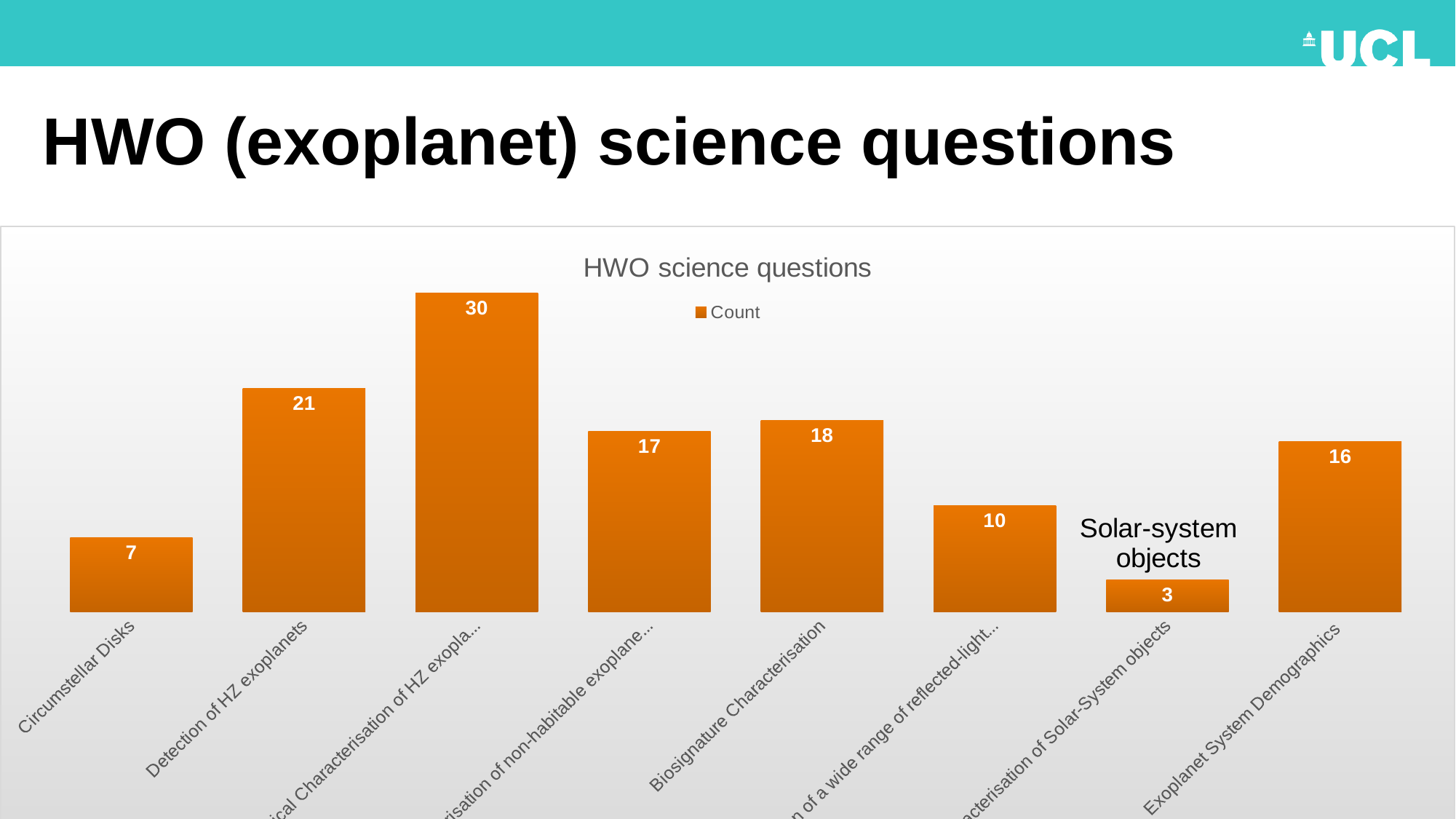
What is the Count for Circumstellar Disks? 7 How many series does the legend list? 1 What is the Count for Exoplanet System Demographics? 16 What is the Count for Biosignature Characterisation? 18 Which category has the lowest Count? Solar-System objects How many bars are shown on the chart? 8 What type of chart is shown on the slide? Bar chart What is the Count for the bar annotated 'Solar-system objects'? 3 What is the Count for Detection of HZ exoplanets? 21 What is the highest Count value shown on the chart? 30 What is the difference in Count between Detection of HZ exoplanets and Circumstellar Disks? 14 Which has a larger Count, Biosignature Characterisation or Exoplanet System Demographics? Biosignature Characterisation